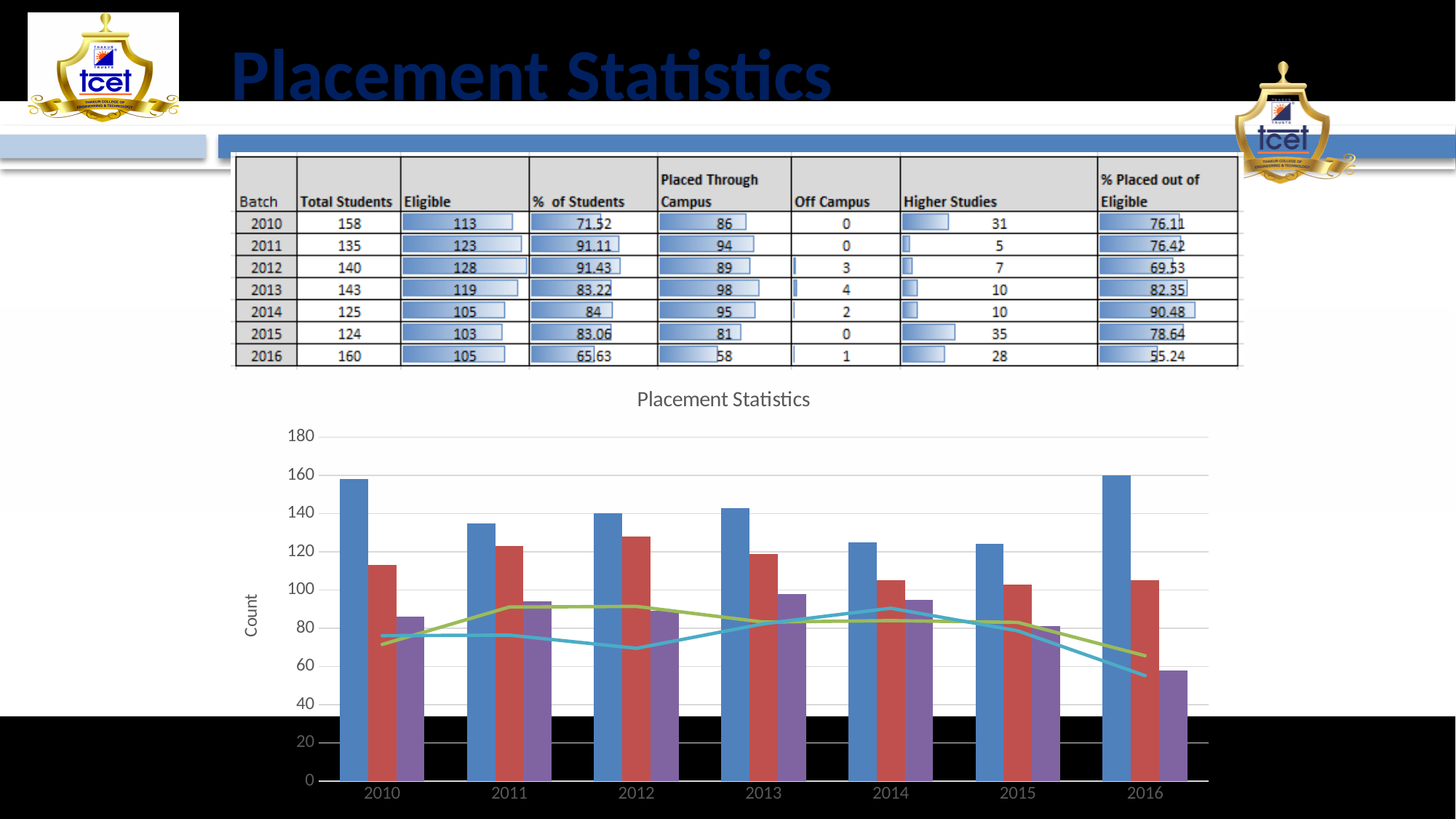
Is the value of the blue bar for 2010 greater or less than 140? greater Is the value of the purple bar for 2016 greater or less than 80? less What kind of chart is shown below the table? bar chart with line series What is the label on the vertical axis of the chart? Count What is the title of the chart? Placement Statistics Does the green line rise or fall from 2014 to 2016? fall Which is taller, the blue bar for 2010 or the blue bar for 2014? 2010 Is the value of the red bar for 2012 greater or less than 120? greater How many bars are plotted for each year in the chart? 3 How many years (categories) are shown on the x axis of the chart? 7 Which year has the shortest purple bar? 2016